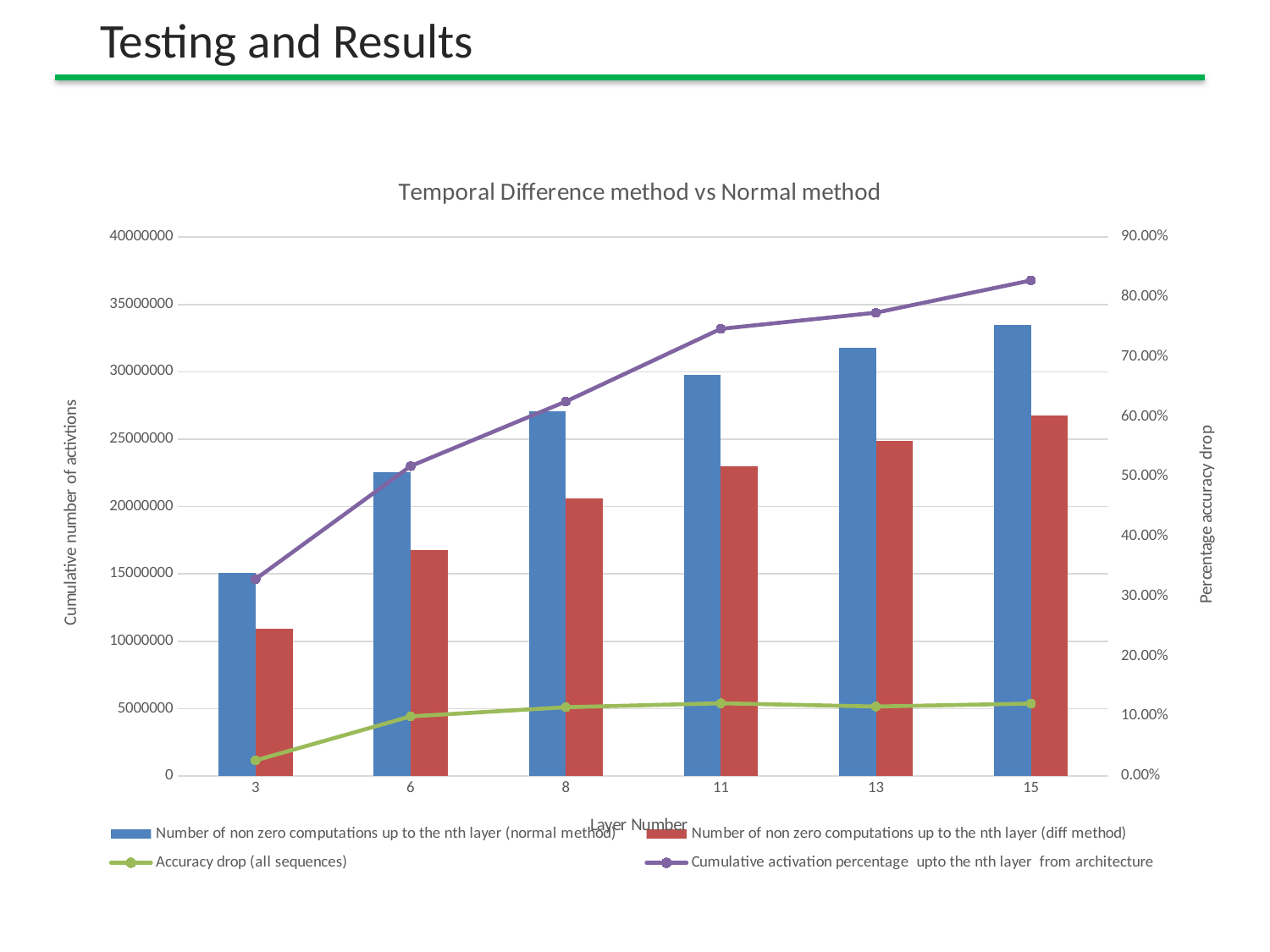
What kind of chart is shown on the slide? Bar and line chart At layer 8, which is larger: the normal method bar or the diff method bar? Normal method How many layer numbers are plotted along the x axis? 6 Is the value for the normal method at layer 3 greater or less than 20000000? less What is the title of the chart? Temporal Difference method vs Normal method Is the cumulative activation percentage at layer 15 greater or less than 80.00%? greater At which layer number is the bar for 'Number of non zero computations up to the nth layer (diff method)' lowest? 3 How many series does the legend list? 4 Do the bars for the normal method rise or fall as the layer number increases? Rise Is the value for the diff method at layer 15 greater or less than 25000000? greater At which layer number is the bar for 'Number of non zero computations up to the nth layer (normal method)' highest? 15